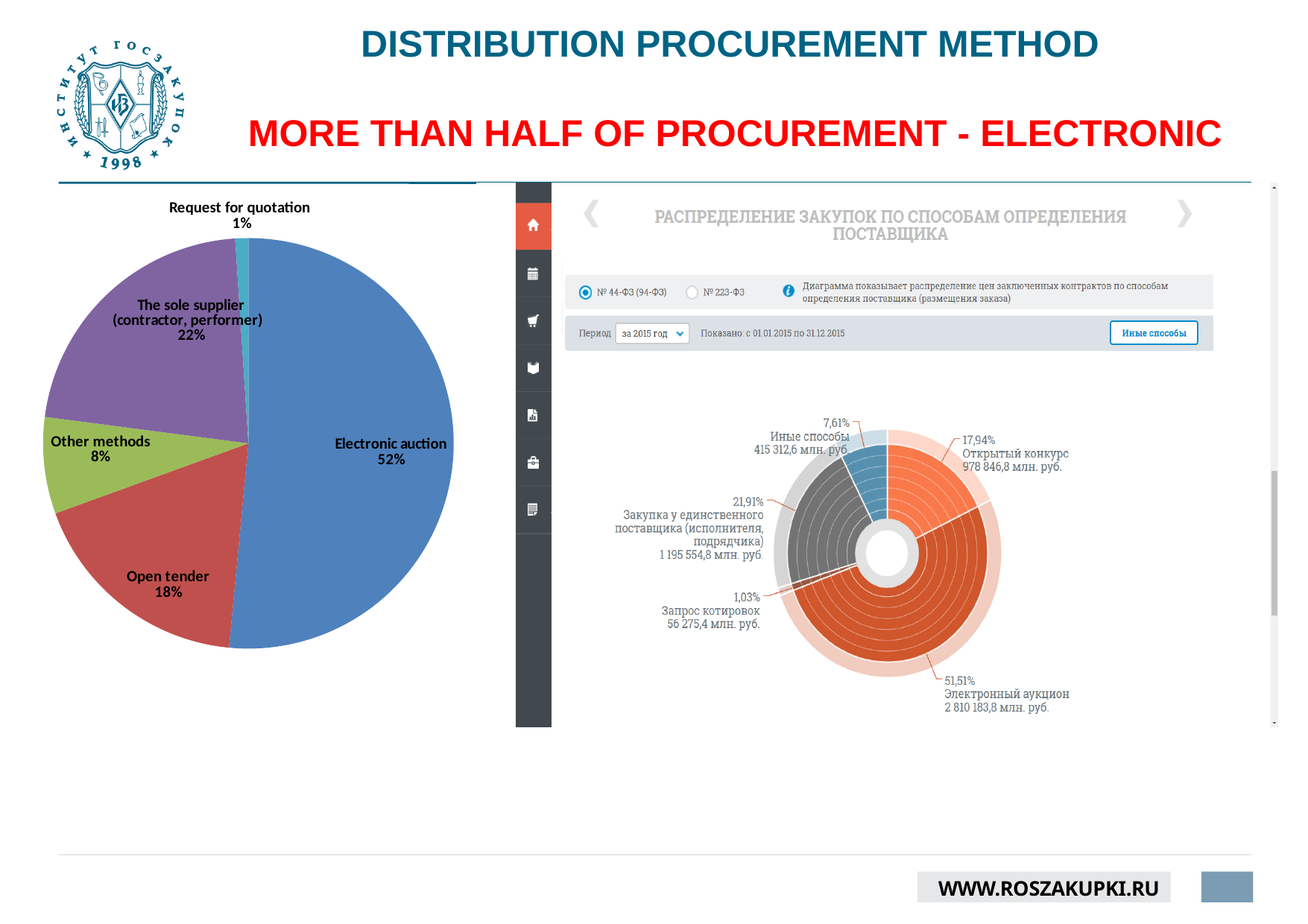
In the pie chart on the left, what share does Open tender have? 18% In the chart on the right, what percentage is shown for Электронный аукцион? 51,51% In the pie chart on the left, what is the difference in percentage points between Electronic auction and Open tender? 34 In the pie chart on the left, which category has the smallest share? Request for quotation In the chart on the right, what value in млн. руб. is shown for Открытый конкурс? 978 846,8 млн. руб. In the pie chart on the left, what colour is the Electronic auction slice? Blue How many categories does the pie chart on the left show? 5 In the pie chart on the left, what share does Electronic auction have? 52% What type of chart is shown on the left of the slide? Pie chart In the pie chart on the left, what share does The sole supplier (contractor, performer) have? 22% In the pie chart on the left, which category has the largest share? Electronic auction In the pie chart on the left, which is larger: Other methods or The sole supplier (contractor, performer)? The sole supplier (contractor, performer)